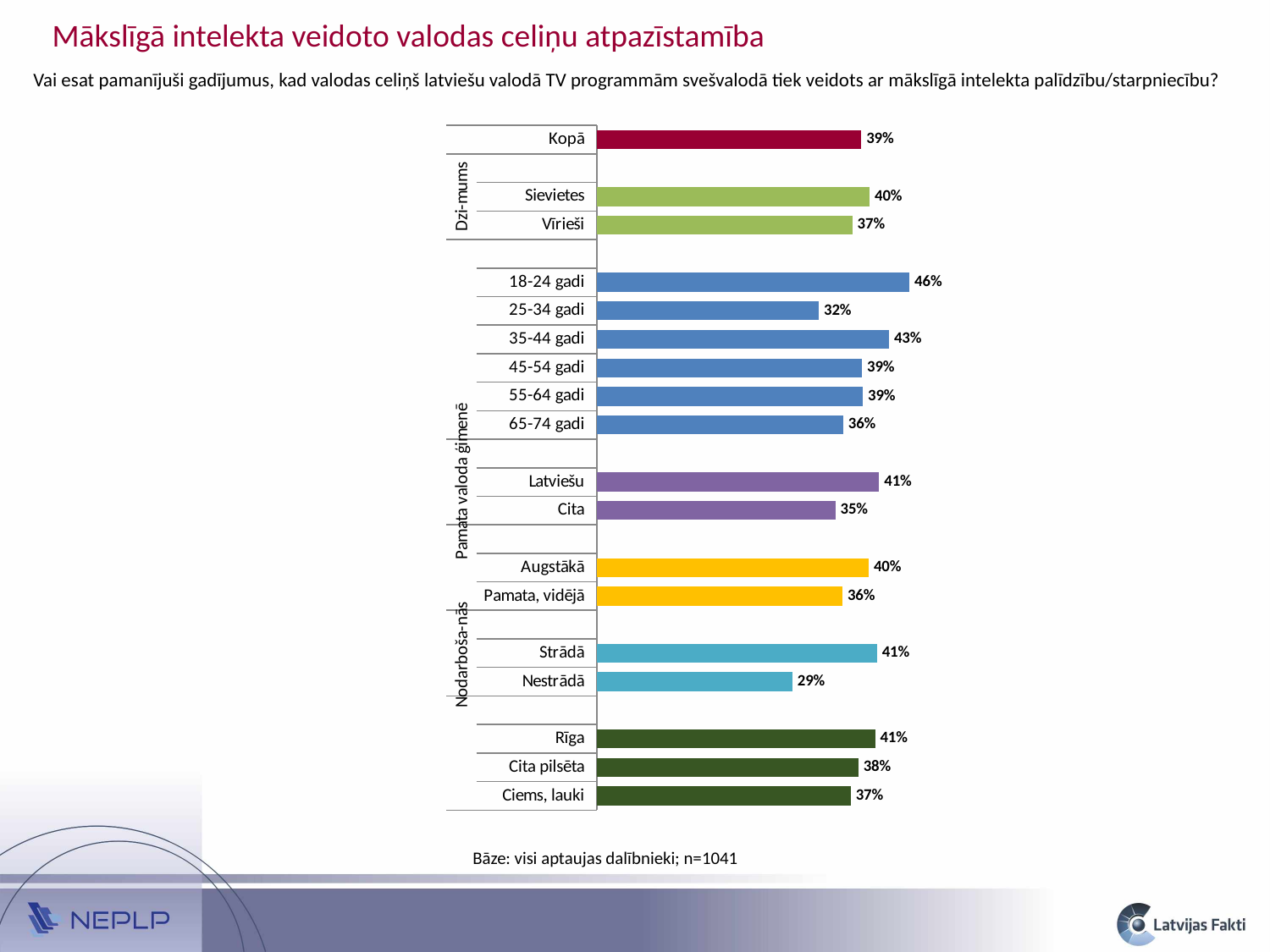
What is the value for Kopā? 39% What is the value for Pamata, vidējā? 36% Which is larger, the value for Latviešu or the value for Cita? Latviešu What is the difference between the values for Sievietes and Vīrieši? 3% Which category has the lowest value? Nestrādā Which category has the highest value? 18-24 gadi Which is larger, the value for 25-34 gadi or the value for 35-44 gadi? 35-44 gadi What is the value for Nestrādā? 29% What kind of chart is shown on the slide? Bar chart What is the difference between the values for Strādā and Nestrādā? 12% How many bars are plotted in the chart? 18 What is the value for 18-24 gadi? 46%